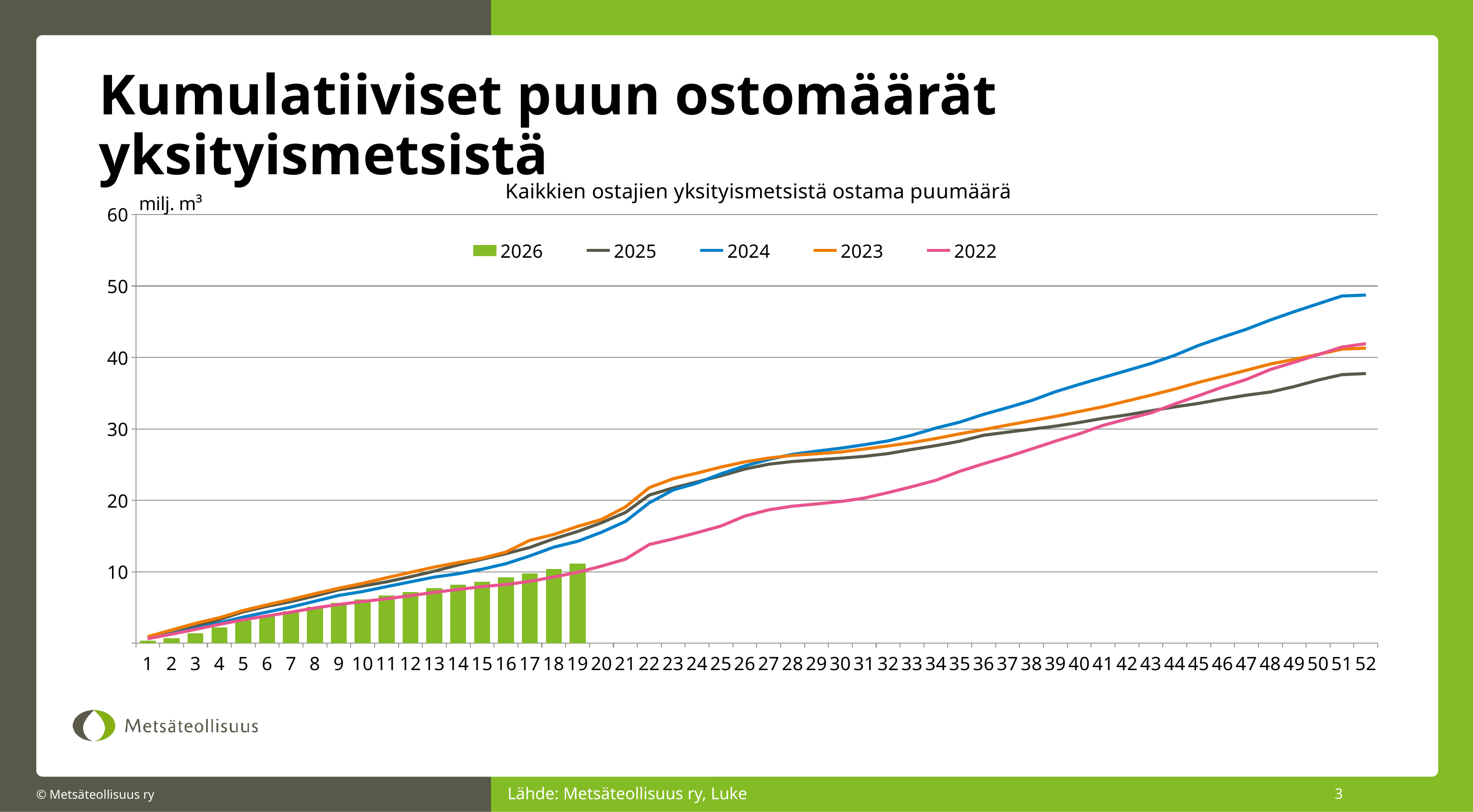
What kind of chart is this? Combined bar and line chart Is the value for 2024 at week 52 greater or less than 40? greater Which year has the highest value at week 52? 2024 How many weeks are shown on the x axis? 52 Is the value for 2025 at week 52 greater or less than 40? less For how many weeks are 2026 bars plotted? 19 What is the title of the chart? Kaikkien ostajien yksityismetsistä ostama puumäärä How many series does the chart legend list? 5 Do the values for 2024 rise or fall along the x axis? rise At week 52, which is larger, the value for 2024 or the value for 2025? 2024 Which year has the lowest value at week 52? 2025 Is the 2026 bar at week 10 greater or less than 10? less